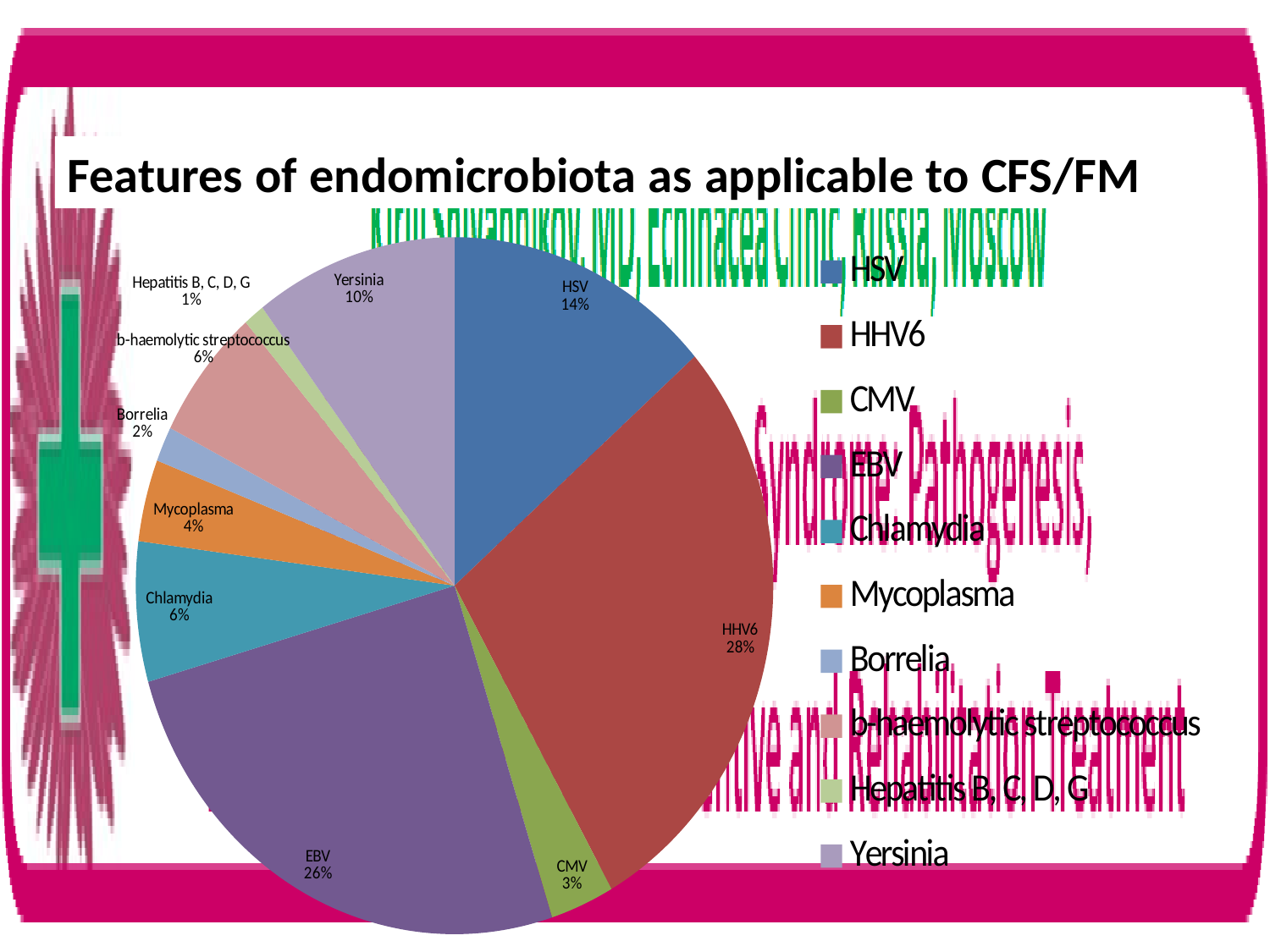
What is the value shown for Mycoplasma? 4% What is the combined share of HHV6 and EBV? 54% What is the difference in percentage points between HHV6 and HSV? 14 How many entries does the legend list? 10 What share of the pie does HHV6 account for? 28% What kind of chart is shown on the slide? pie chart What is the value shown for Yersinia? 10% How many categories are shown in the pie chart? 10 Which category has the smallest slice of the pie? Hepatitis B, C, D, G What share of the pie does EBV account for? 26% Which category has the largest slice of the pie? HHV6 Which is larger, the slice for Chlamydia or the slice for CMV? Chlamydia